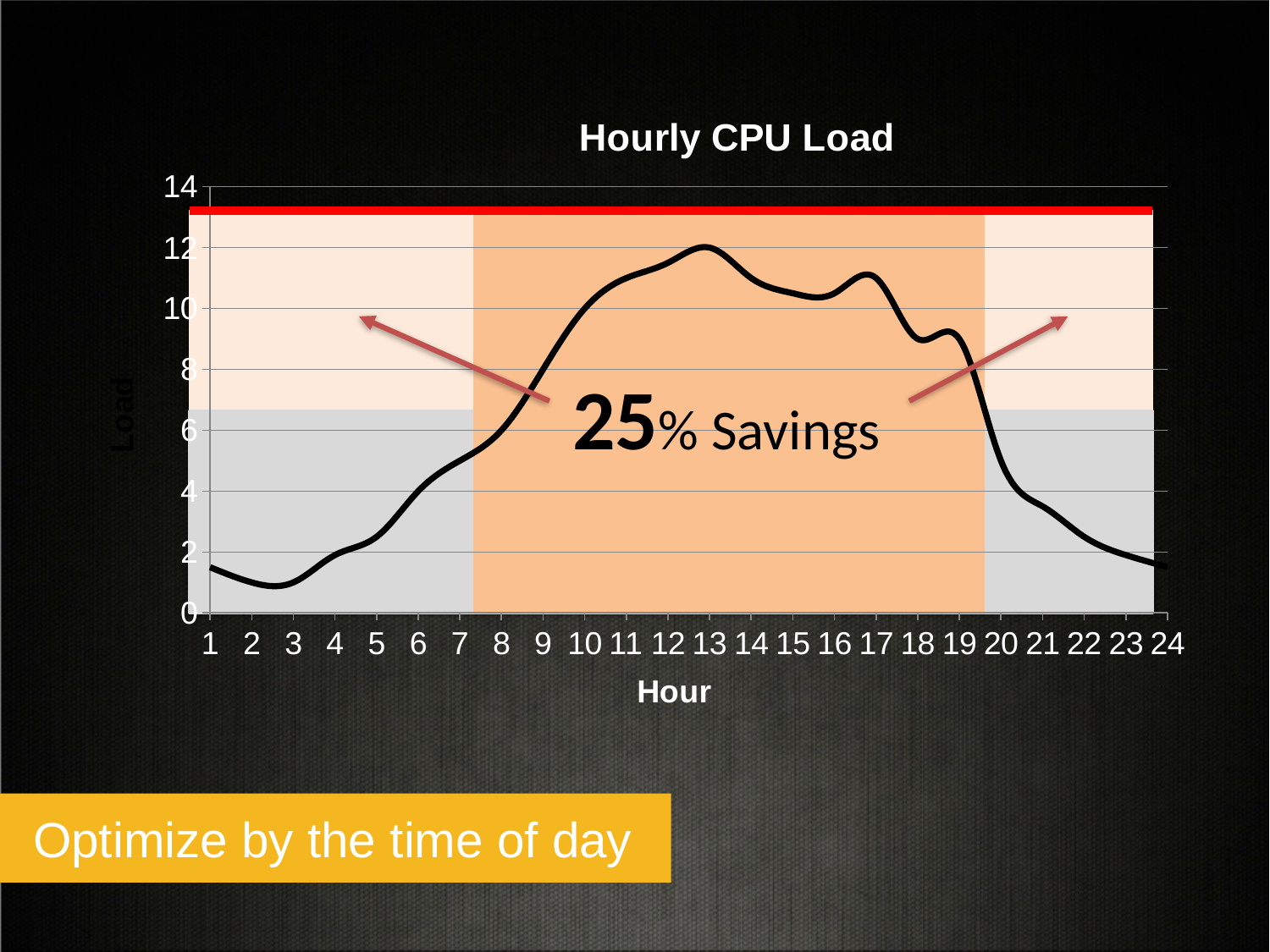
Is the load at hour 22 greater or less than 4? less Is the load at hour 18 greater or less than 10? less What is the title of the chart? Hourly CPU Load Which hour has the higher load, hour 12 or hour 22? hour 12 How many hours are plotted along the x axis of the chart? 24 Is the load at hour 13 greater or less than 10? greater At which hour does the CPU load reach its highest value? 13 Does the load rise or fall from hour 1 to hour 13? rise What savings percentage is annotated on the chart? 25% Savings What kind of chart is shown on the slide? line chart